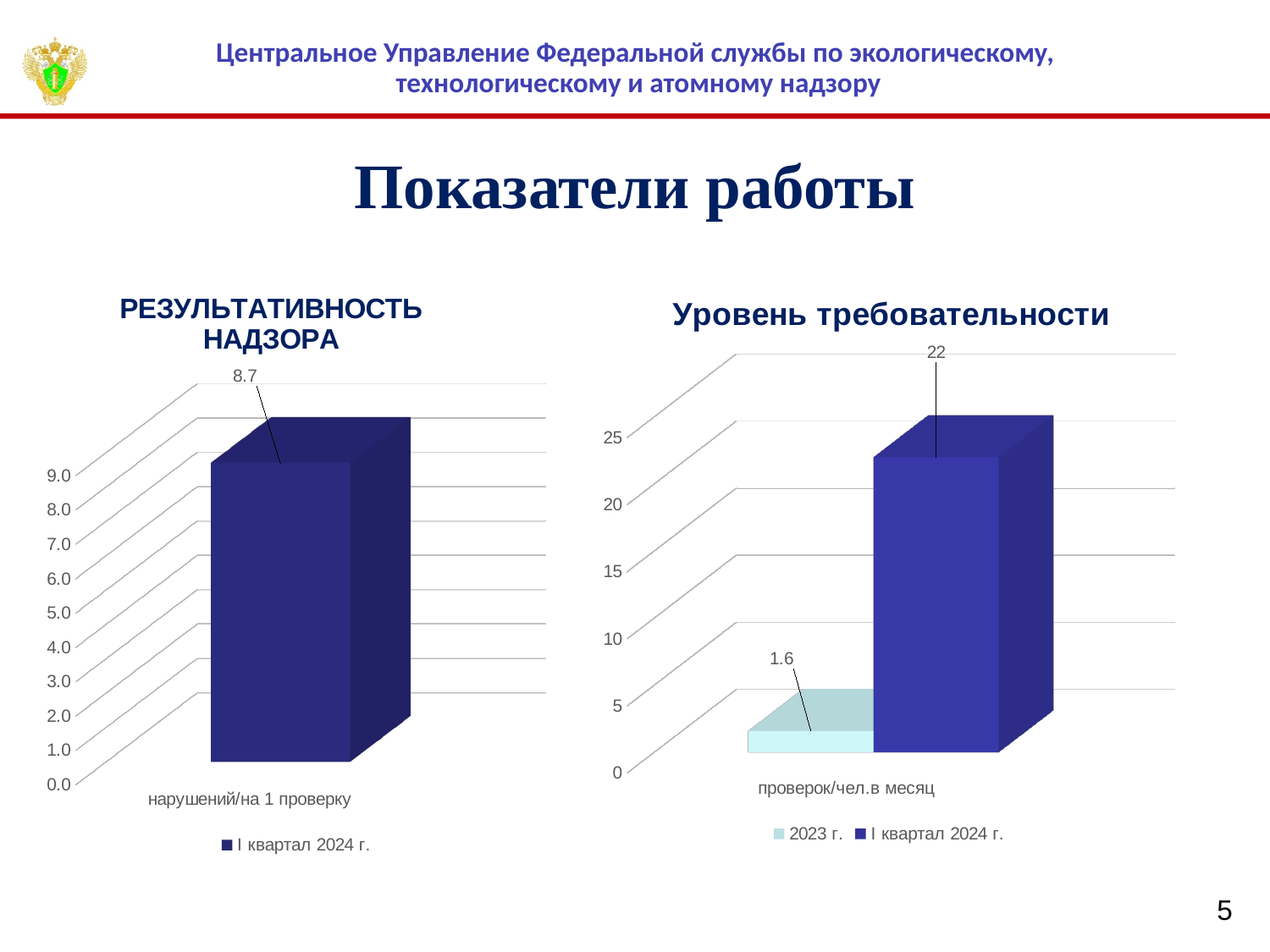
In the chart titled "Уровень требовательности", what is the value for I квартал 2024 г.? 22 In the chart titled "Уровень требовательности", what is the difference between the I квартал 2024 г. value and the 2023 г. value? 20.4 In the chart titled "РЕЗУЛЬТАТИВНОСТЬ НАДЗОРА", what is the value for "нарушений/на 1 проверку" for I квартал 2024 г.? 8.7 In the chart titled "РЕЗУЛЬТАТИВНОСТЬ НАДЗОРА", how many series does the legend list? 1 In the chart titled "Уровень требовательности", what is the category label on the x axis? проверок/чел.в месяц In the chart titled "Уровень требовательности", which series is the lowest? 2023 г. What kind of chart is the chart titled "Уровень требовательности"? bar chart In the chart titled "Уровень требовательности", is the value for I квартал 2024 г. greater or less than 20? greater In the chart titled "Уровень требовательности", which series has the higher value: 2023 г. or I квартал 2024 г.? I квартал 2024 г. In the chart titled "Уровень требовательности", how many series does the legend list? 2 In the chart titled "РЕЗУЛЬТАТИВНОСТЬ НАДЗОРА", is the value for "нарушений/на 1 проверку" greater or less than 8.0? greater In the chart titled "Уровень требовательности", what is the value for 2023 г.? 1.6